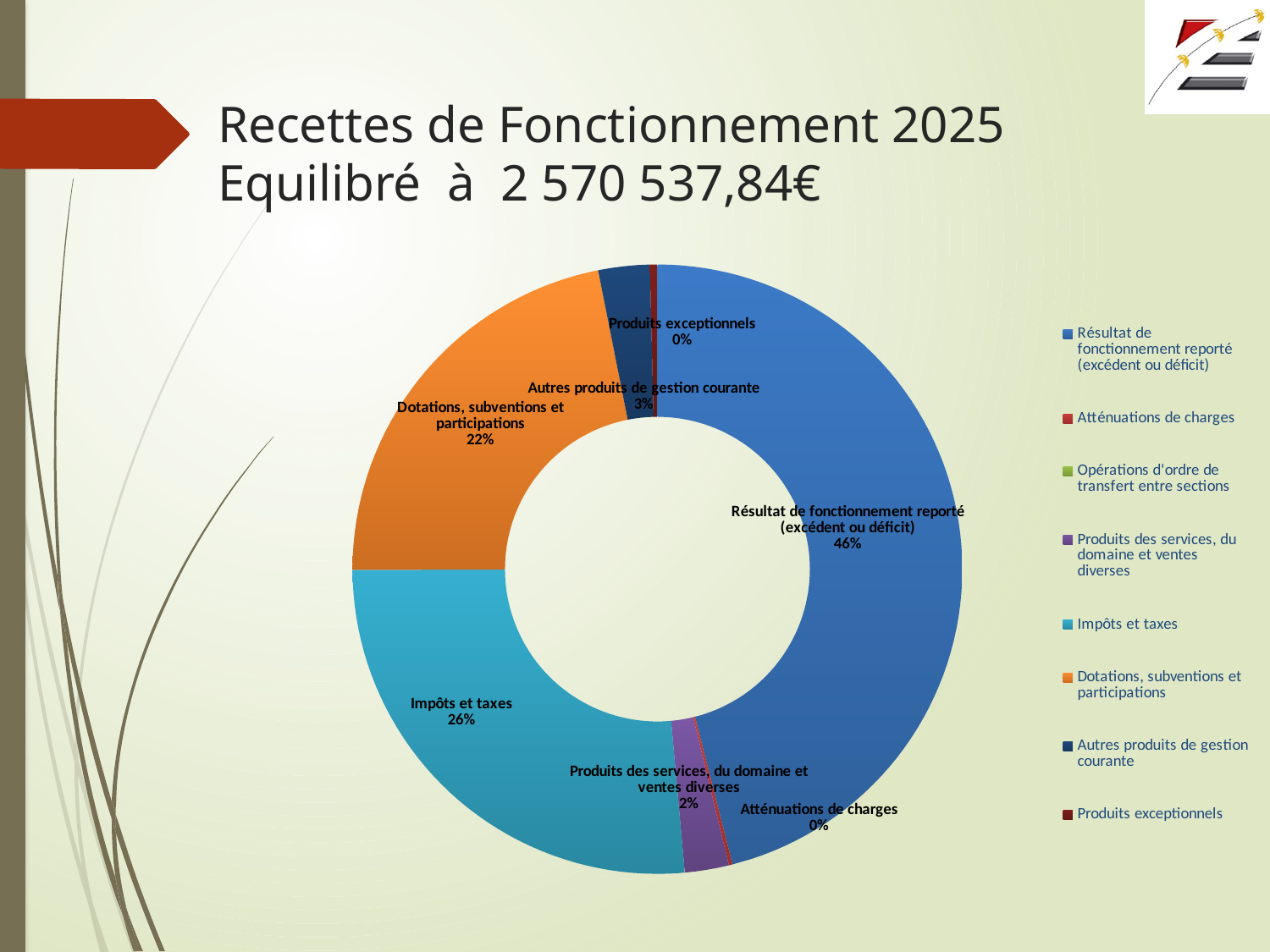
What share of the doughnut chart is 'Résultat de fonctionnement reporté (excédent ou déficit)'? 46% What percentage is shown for 'Autres produits de gestion courante'? 3% Which is larger, the share for 'Impôts et taxes' or for 'Dotations, subventions et participations'? Impôts et taxes What is the title of the slide containing the chart? Recettes de Fonctionnement 2025 Equilibré à 2 570 537,84€ What percentage is shown for 'Produits exceptionnels'? 0% Which category has the largest share of the chart? Résultat de fonctionnement reporté (excédent ou déficit) What percentage is shown for 'Produits des services, du domaine et ventes diverses'? 2% What kind of chart is shown on the slide? Doughnut (pie) chart What share of the doughnut chart is 'Dotations, subventions et participations'? 22% What share of the doughnut chart is 'Impôts et taxes'? 26% What is the difference in percentage points between 'Résultat de fonctionnement reporté (excédent ou déficit)' and 'Impôts et taxes'? 20 percentage points How many entries does the chart legend list? 8